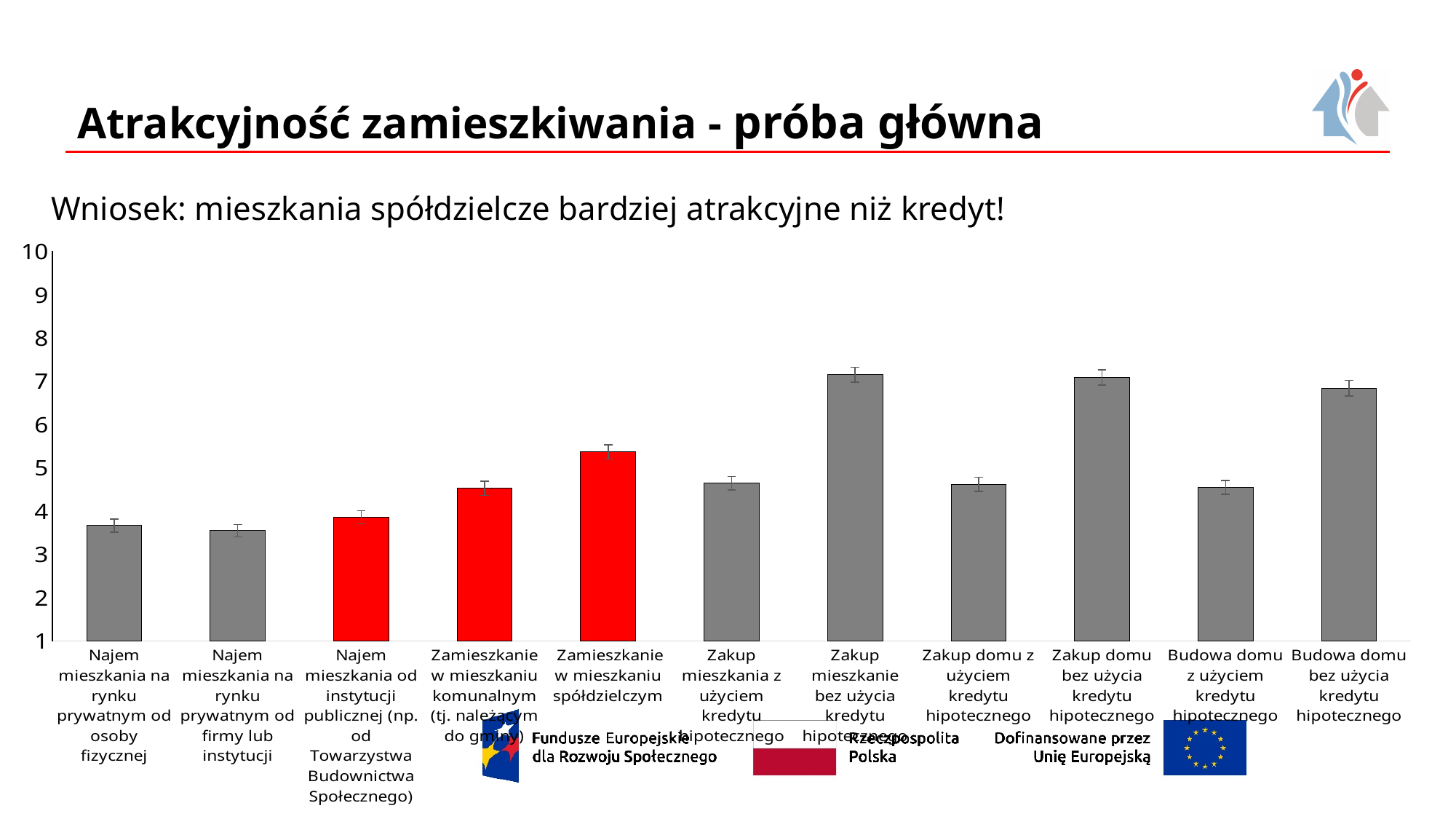
Is the value for "Zakup mieszkanie bez użycia kredytu hipotecznego" greater or less than 6? greater Which has the lower value: "Budowa domu z użyciem kredytu hipotecznego" or "Budowa domu bez użycia kredytu hipotecznego"? Budowa domu z użyciem kredytu hipotecznego Is the value for "Zamieszkanie w mieszkaniu spółdzielczym" greater or less than 5? greater Which has the higher value: "Zamieszkanie w mieszkaniu spółdzielczym" or "Zamieszkanie w mieszkaniu komunalnym"? Zamieszkanie w mieszkaniu spółdzielczym How many categories (bars) does the chart show? 11 Is the value for "Zakup mieszkania z użyciem kredytu hipotecznego" greater or less than 5? less How many bars in the chart are coloured red? 3 What kind of chart is shown on the slide? bar chart Which has the higher value: "Zakup domu bez użycia kredytu hipotecznego" or "Zakup domu z użyciem kredytu hipotecznego"? Zakup domu bez użycia kredytu hipotecznego What is the highest value shown on the vertical axis of the chart? 10